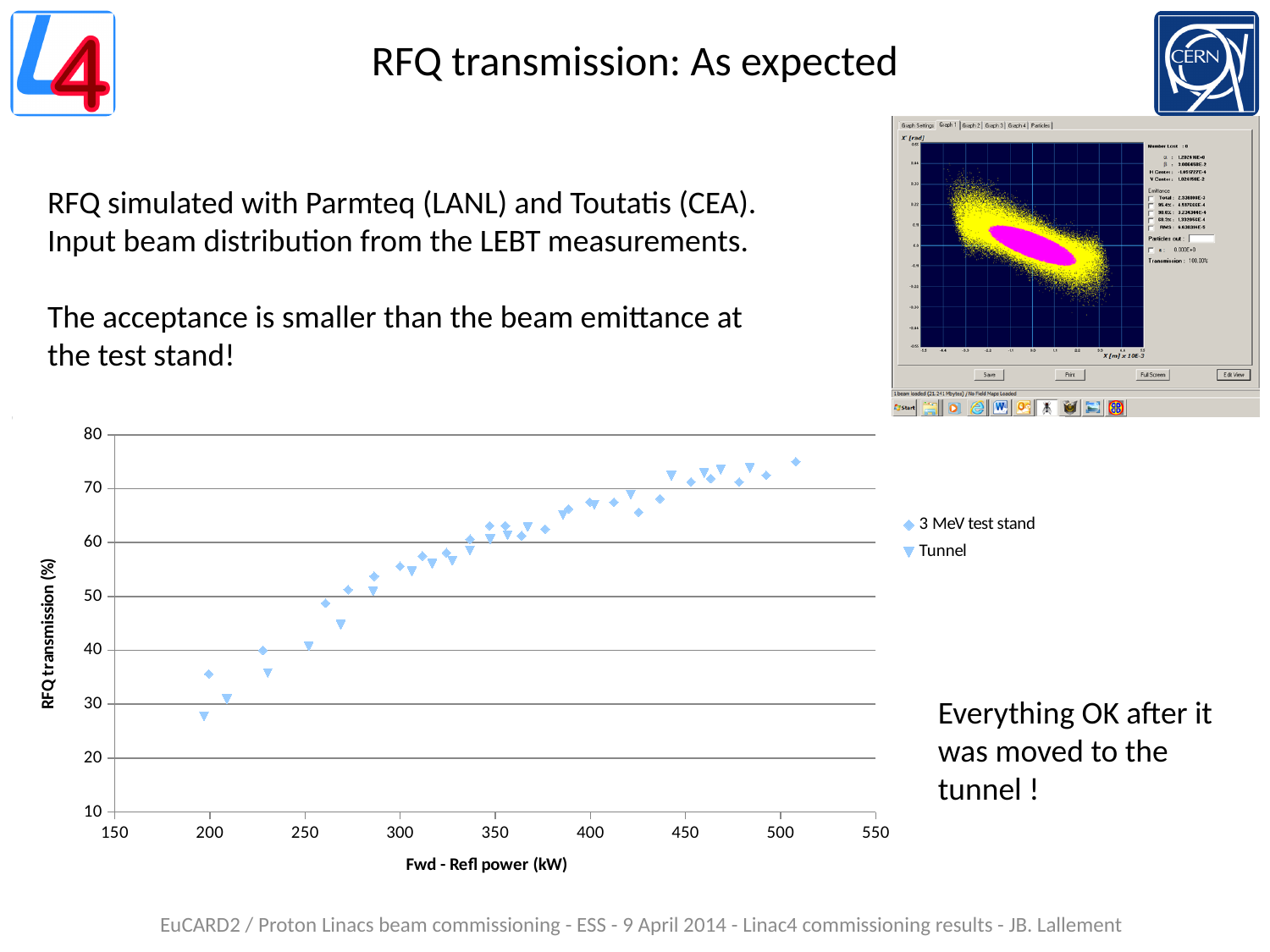
Does RFQ transmission rise or fall as Fwd - Refl power increases along the x axis? rise What kind of chart is shown on the slide? scatter chart Is the RFQ transmission of the Tunnel point near 230 kW greater or less than 40? less Which series has the lowest plotted RFQ transmission value on the chart? Tunnel How many series does the chart legend list? 2 Is the RFQ transmission of the lowest plotted point (near 200 kW) greater or less than 30? less What is the maximum value shown on the chart's y axis? 80 Is the RFQ transmission of the 3 MeV test stand point near 260 kW greater or less than 40? greater What is the title of the chart's x axis? Fwd - Refl power (kW) What are the two series named in the chart legend? 3 MeV test stand and Tunnel